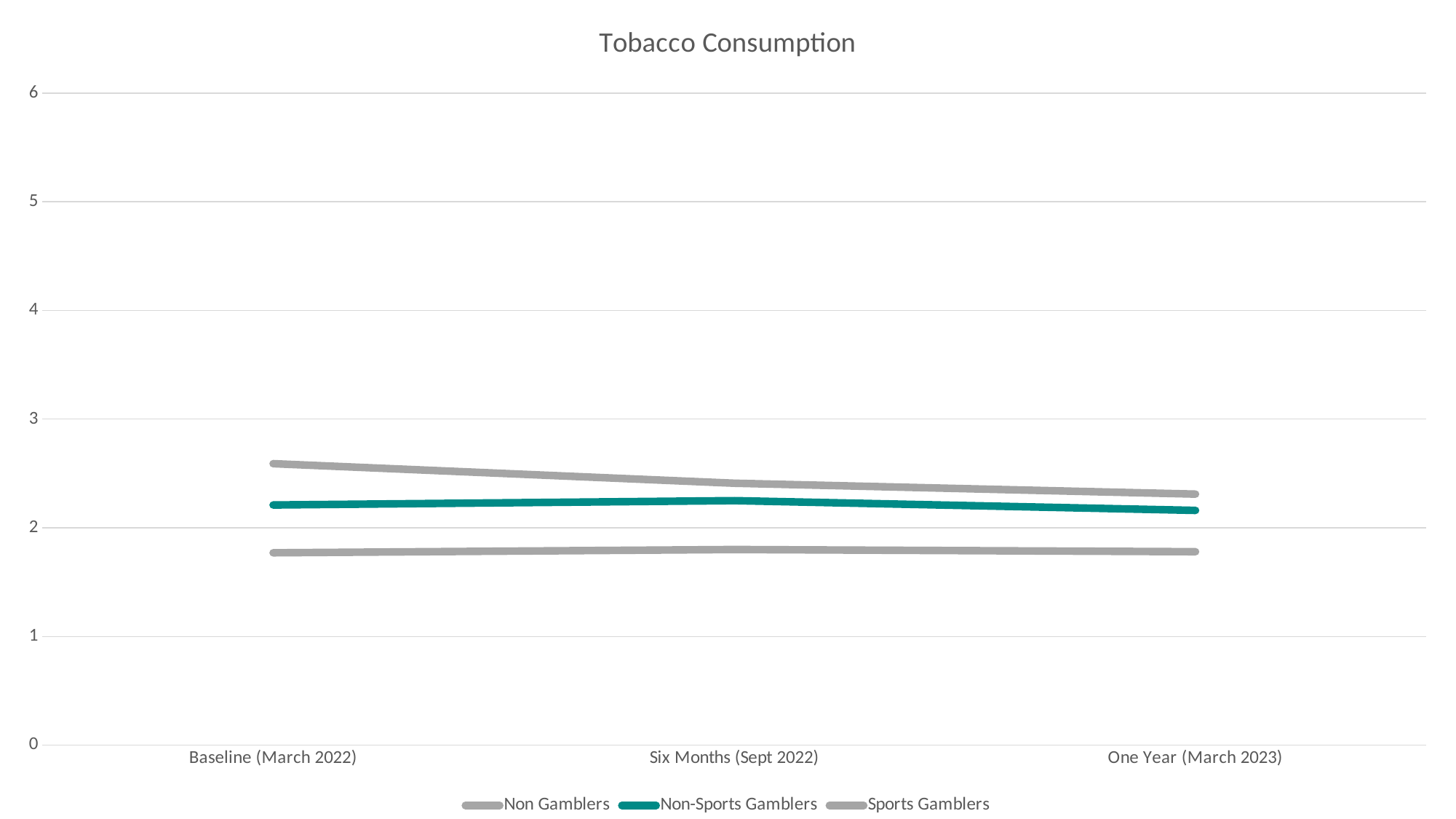
How many of the three lines are above the Non-Sports Gamblers line at One Year (March 2023)? 1 How many time points are shown on the x axis? 3 Is the value for Non-Sports Gamblers at One Year (March 2023) greater or less than 4? less At Baseline (March 2022), is the Non-Sports Gamblers line the highest, middle, or lowest of the three lines? middle Is the value for Non-Sports Gamblers at One Year (March 2023) greater or less than 2? greater How many series does the legend list? 3 Do any of the three lines reach a value of 3 at any time point? No What kind of chart is shown on the slide? line chart What is the label of the first point on the x axis? Baseline (March 2022) What is the title of the chart? Tobacco Consumption